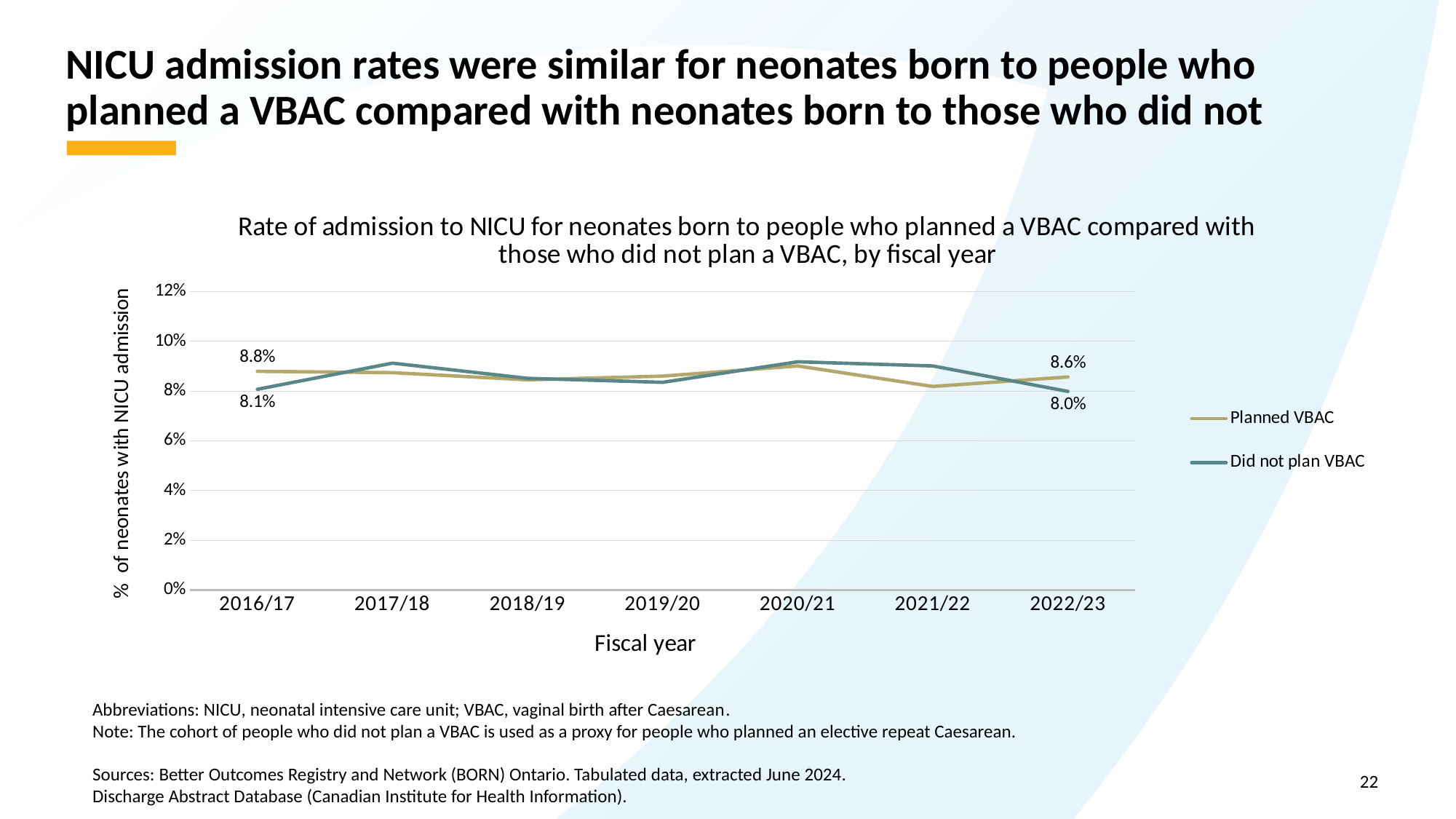
Is the value for Did not plan VBAC in 2017/18 greater or less than 8%? greater What was the NICU admission rate for Planned VBAC in 2022/23? 8.6% What was the NICU admission rate for Did not plan VBAC in 2016/17? 8.1% What was the NICU admission rate for Planned VBAC in 2016/17? 8.8% What is the label of the x axis? Fiscal year What is the difference between the Planned VBAC and Did not plan VBAC rates in 2016/17? 0.7% What kind of chart is shown on the slide? Line chart How many fiscal years are shown on the x axis? 7 In 2022/23, which series had the higher NICU admission rate, Planned VBAC or Did not plan VBAC? Planned VBAC How many series does the legend list? 2 What is the difference between the Planned VBAC and Did not plan VBAC rates in 2022/23? 0.6% What was the NICU admission rate for Did not plan VBAC in 2022/23? 8.0%